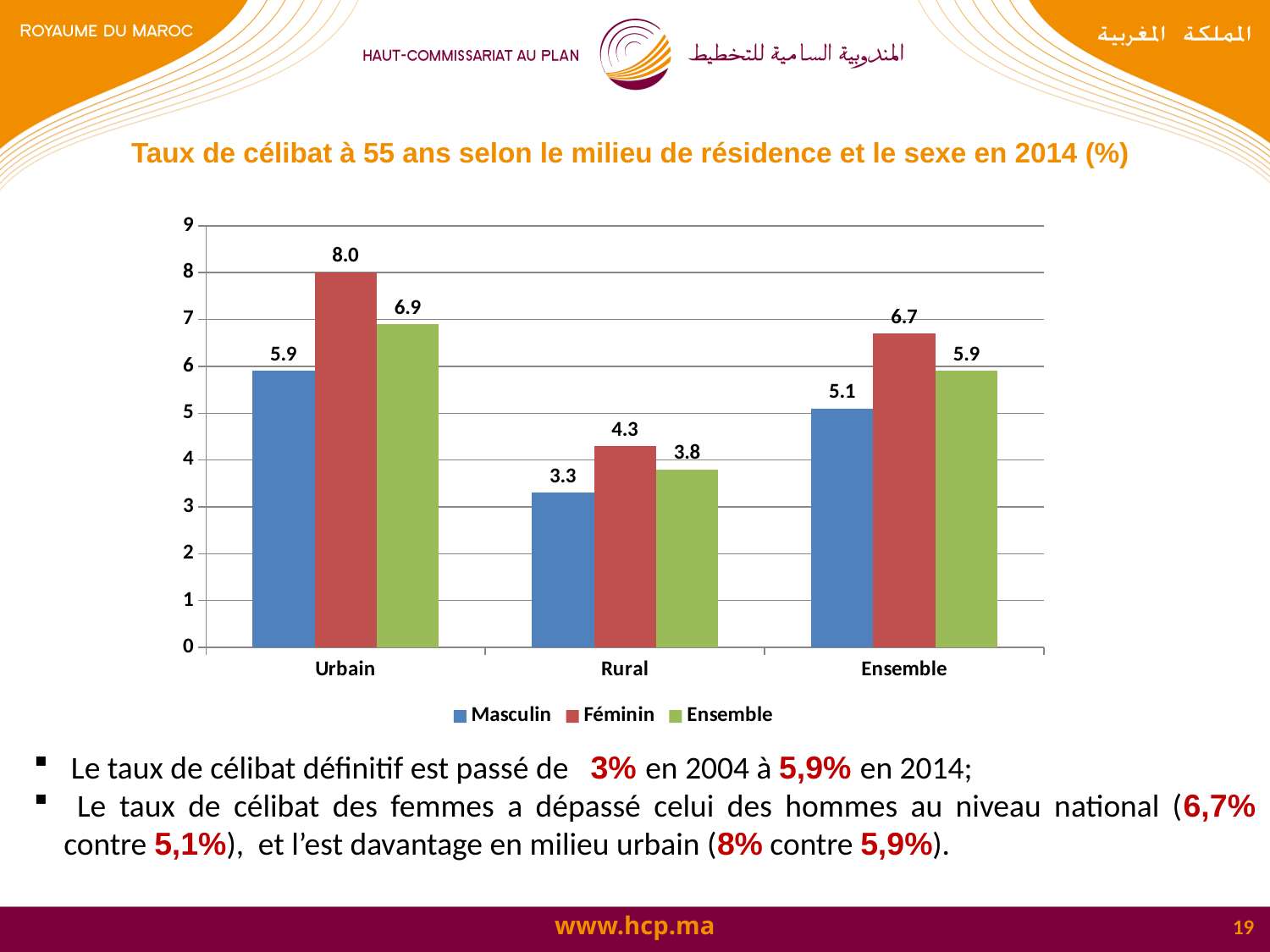
What is the difference between the Féminin and Masculin values in the Ensemble category? 1.6 How many series does the legend list? 3 Which category has the highest Féminin value? Urbain What kind of chart is shown on the slide? bar chart What is the value for Masculin in the Rural category? 3.3 Which category has the lowest Masculin value? Rural What is the value for Féminin in the Urbain category? 8.0 Which is larger in the Rural category, the Féminin value or the Ensemble value? Féminin What is the value for the Ensemble series in the Ensemble category? 5.9 What is the title of the chart? Taux de célibat à 55 ans selon le milieu de résidence et le sexe en 2014 (%) How many categories are shown on the x axis? 3 What is the difference between the Féminin and Masculin values in the Urbain category? 2.1